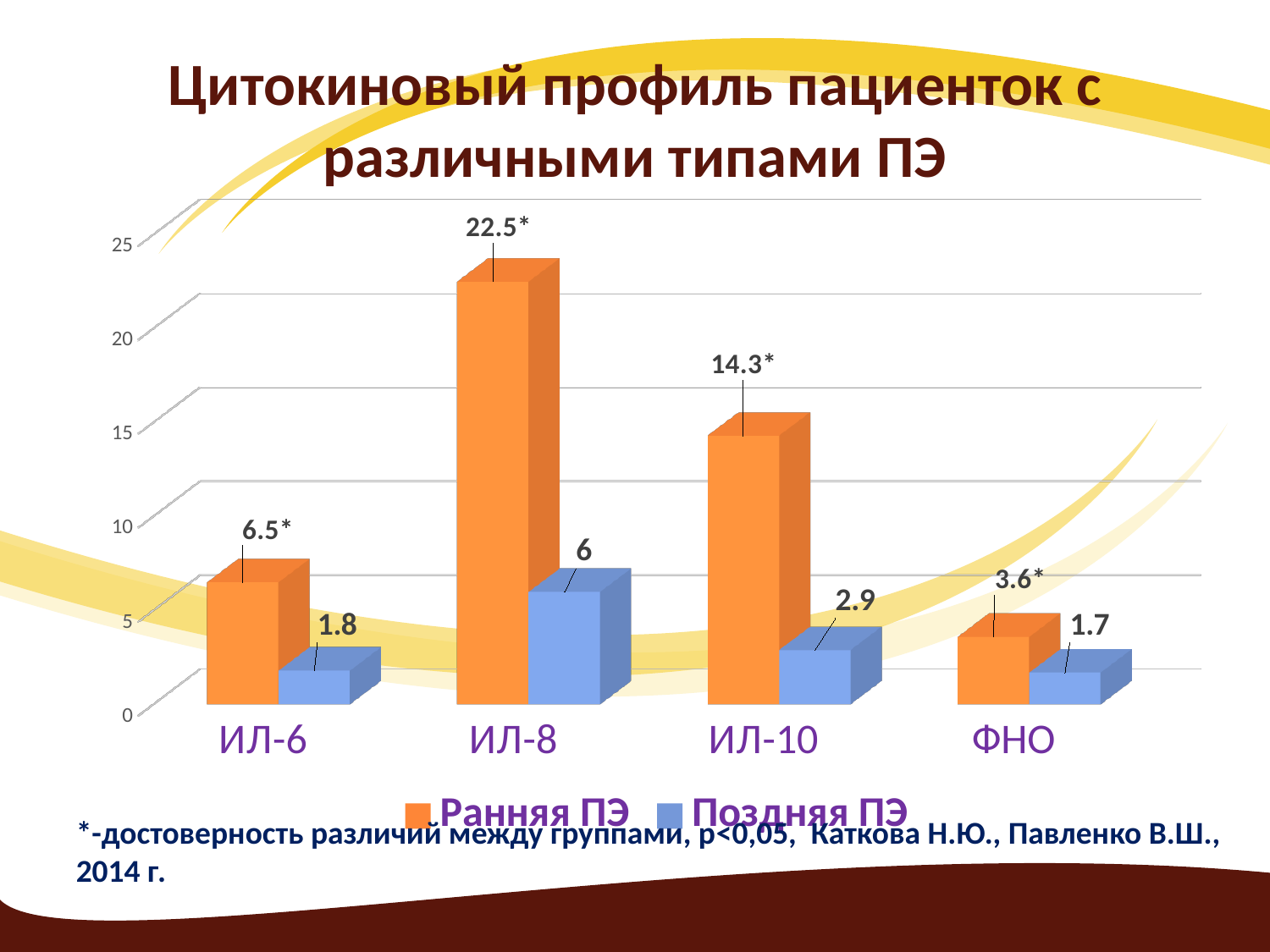
What is the value for ФНО in the Ранняя ПЭ series? 3.6* What is the value for ИЛ-10 in the Поздняя ПЭ series? 2.9 Which colour represents the Поздняя ПЭ series? blue How many categories are shown on the x axis? 4 How many series does the legend list? 2 Which category has the lowest value in the Поздняя ПЭ series? ФНО Which category has the highest value in the Ранняя ПЭ series? ИЛ-8 Which is larger for ИЛ-10: the Ранняя ПЭ value or the Поздняя ПЭ value? Ранняя ПЭ What type of chart is shown on the slide? bar chart What is the difference between the Ранняя ПЭ and Поздняя ПЭ values for ИЛ-8? 16.5 What is the value for ИЛ-6 in the Поздняя ПЭ series? 1.8 What is the value for ИЛ-8 in the Ранняя ПЭ series? 22.5*